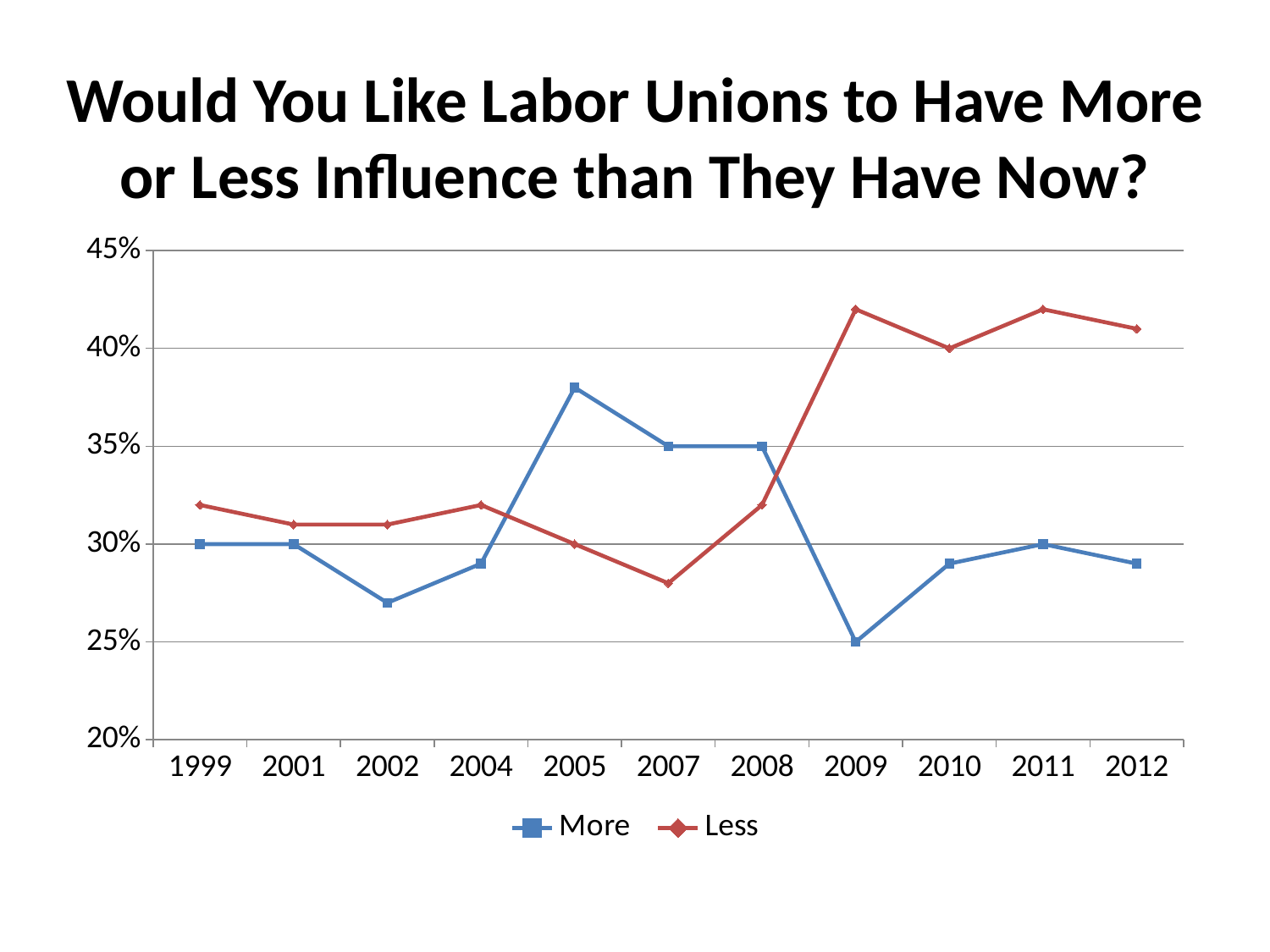
What is the value for More in 2009? 25% What kind of chart is shown on the slide? line chart How many series does the legend list? 2 Is the value for Less in 2009 greater or less than 40%? greater In 2005, which series has the larger value, More or Less? More Which series is shown in red? Less Is the value for More in 2002 greater or less than 30%? less What is the value for Less in 2010? 40% How many years are shown on the x axis? 11 In which year is the More series at its highest? 2005 What is the value for More in 2007? 35% What is the value for More in 1999? 30%